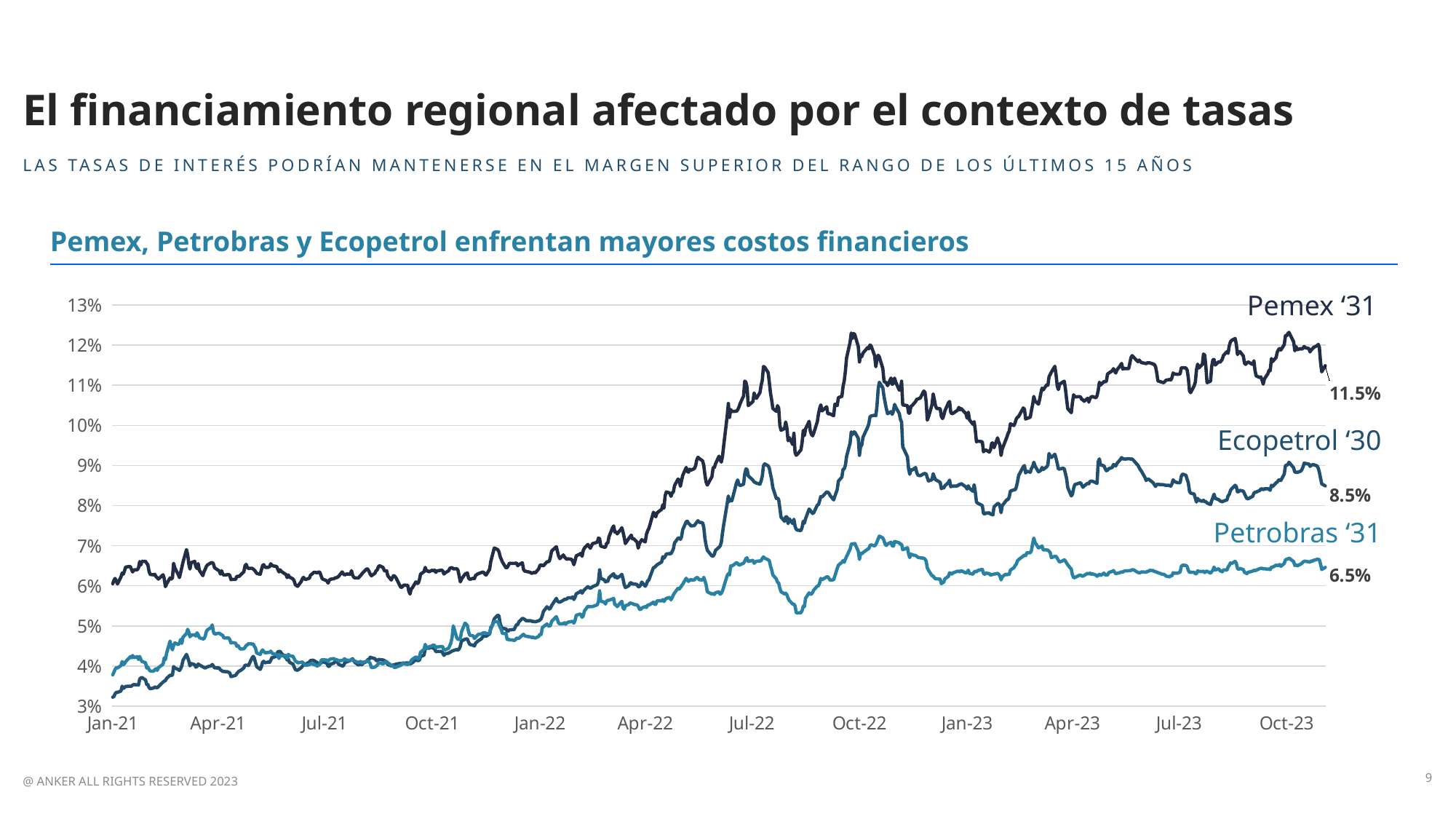
Overall, do the Pemex '31 values rise or fall from Jan-21 to Oct-23? Rise Which series has the lowest value at the end of the chart? Petrobras '31 What is the difference between the final values of Ecopetrol '30 and Petrobras '31? 2.0% What is the difference between the final values of Pemex '31 and Petrobras '31? 5.0% What is the latest value shown for Pemex '31? 11.5% Is the value for Pemex '31 in Jan-21 greater or less than 8%? less What is the latest value shown for Petrobras '31? 6.5% What kind of chart is shown on the slide? Line chart What is the latest value shown for Ecopetrol '30? 8.5% Which series has the highest value at the end of the chart? Pemex '31 At the end of the chart, which is larger: Ecopetrol '30 or Petrobras '31? Ecopetrol '30 How many series are plotted on the chart? 3